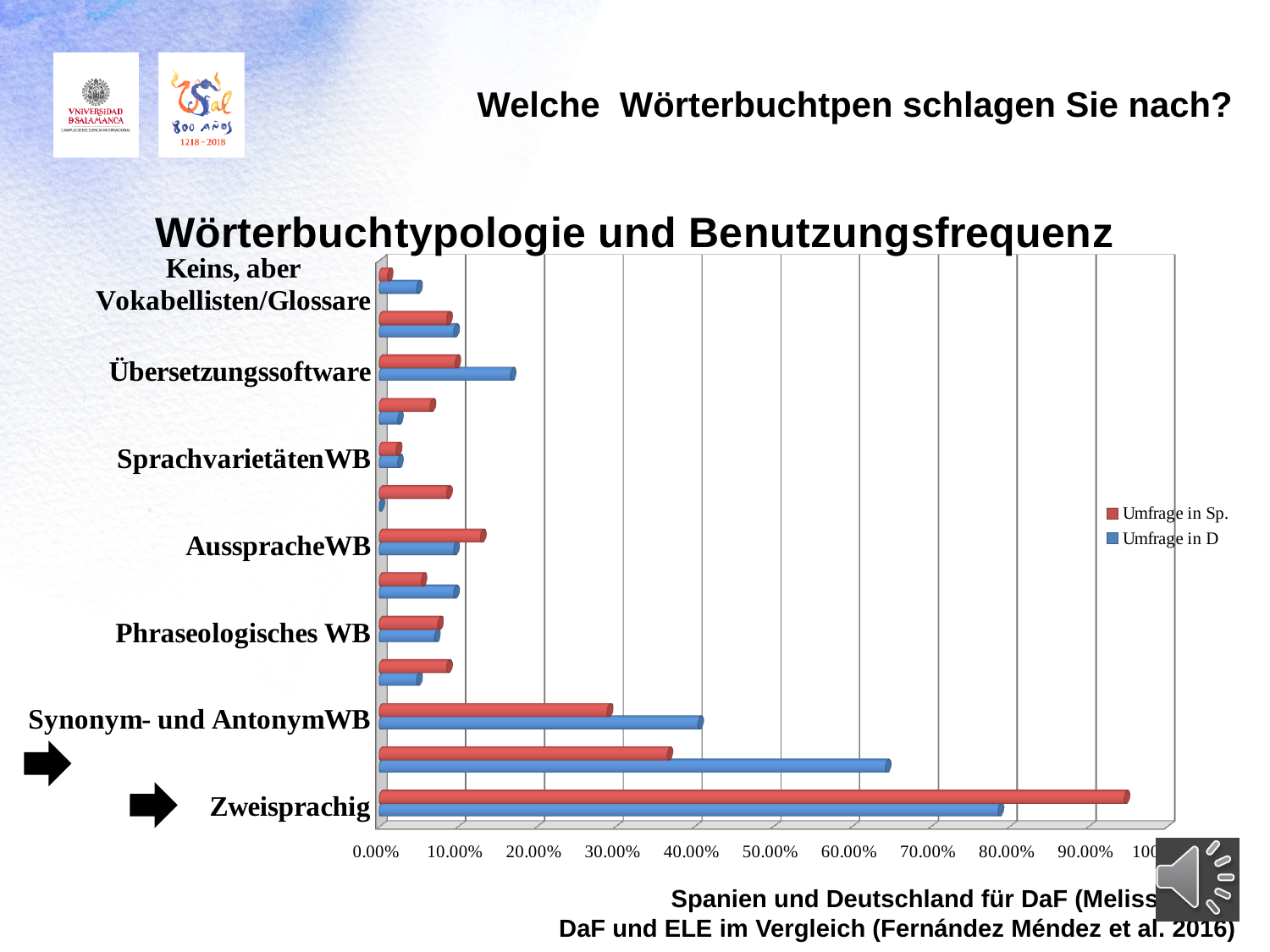
Which category has the highest value for the Umfrage in D series? Zweisprachig Which category has the highest value for the Umfrage in Sp. series? Zweisprachig For Übersetzungssoftware, which series has the larger value, Umfrage in Sp. or Umfrage in D? Umfrage in D Is the Umfrage in Sp. value for Zweisprachig greater or less than 90.00%? greater For Synonym- und AntonymWB, which series has the larger value, Umfrage in Sp. or Umfrage in D? Umfrage in D Is the Umfrage in D value for Zweisprachig greater or less than 70.00%? greater Is the Umfrage in D value for Synonym- und AntonymWB greater or less than 30.00%? greater What is the title of the chart? Wörterbuchtypologie und Benutzungsfrequenz What are the two series named in the chart legend? Umfrage in Sp. and Umfrage in D What kind of chart is shown on the slide? bar chart How many series does the chart legend list? 2